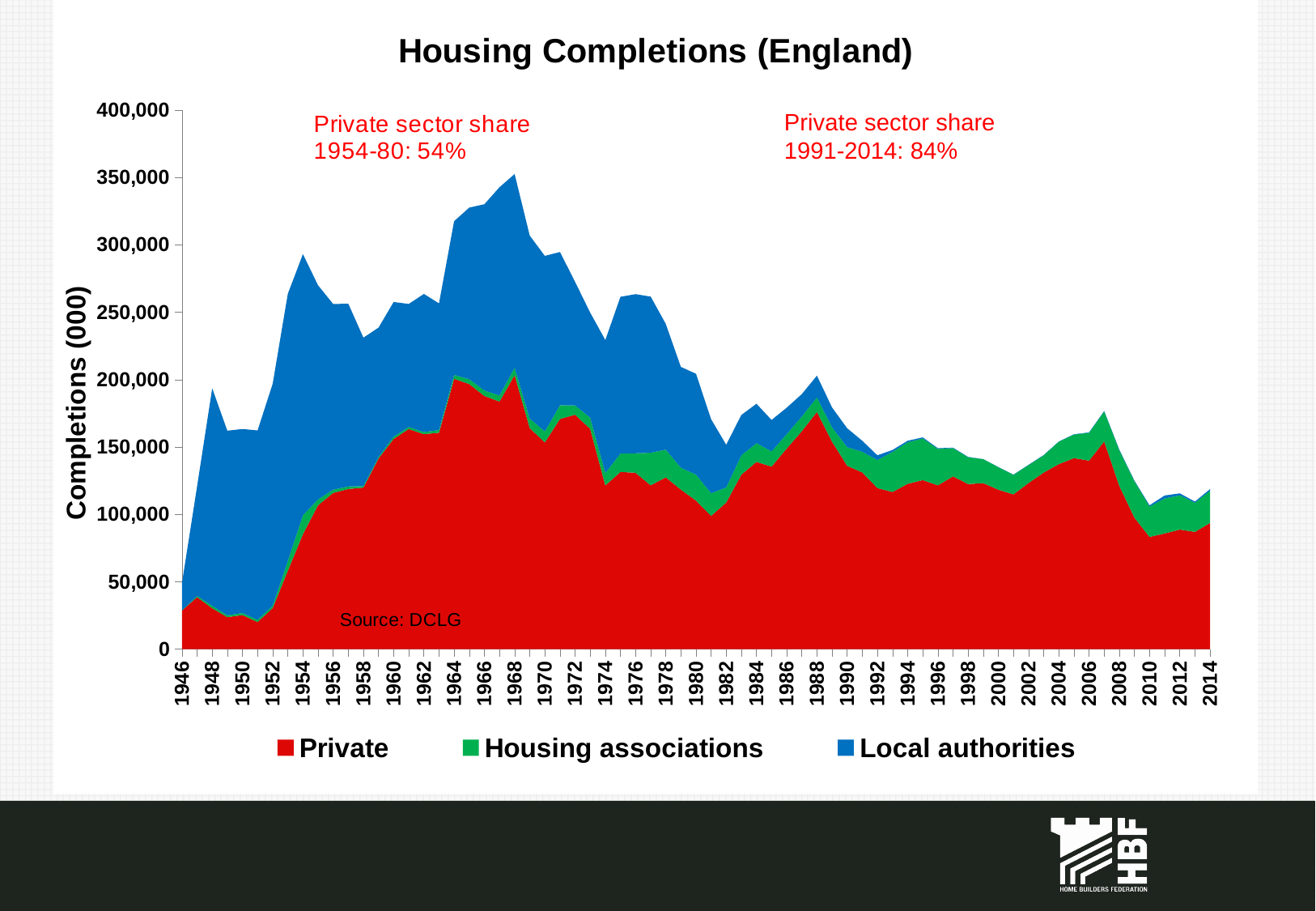
Is the total number of completions in 2010 greater or less than 150,000? less Which year has the larger total number of completions, 1954 or 1988? 1954 Do total housing completions rise or fall between 1968 and 1982? fall In which year do total housing completions reach their highest point? 1968 Is the total number of completions in 1954 greater or less than 250,000? greater According to the annotation, what was the private sector share of completions in 1954-80? 54% According to the annotation, what was the private sector share of completions in 1991-2014? 84% Is the total number of completions in 1968 greater or less than 300,000? greater What kind of chart is shown on the slide? Stacked area chart What is the title of the chart? Housing Completions (England) How many series does the legend list? 3